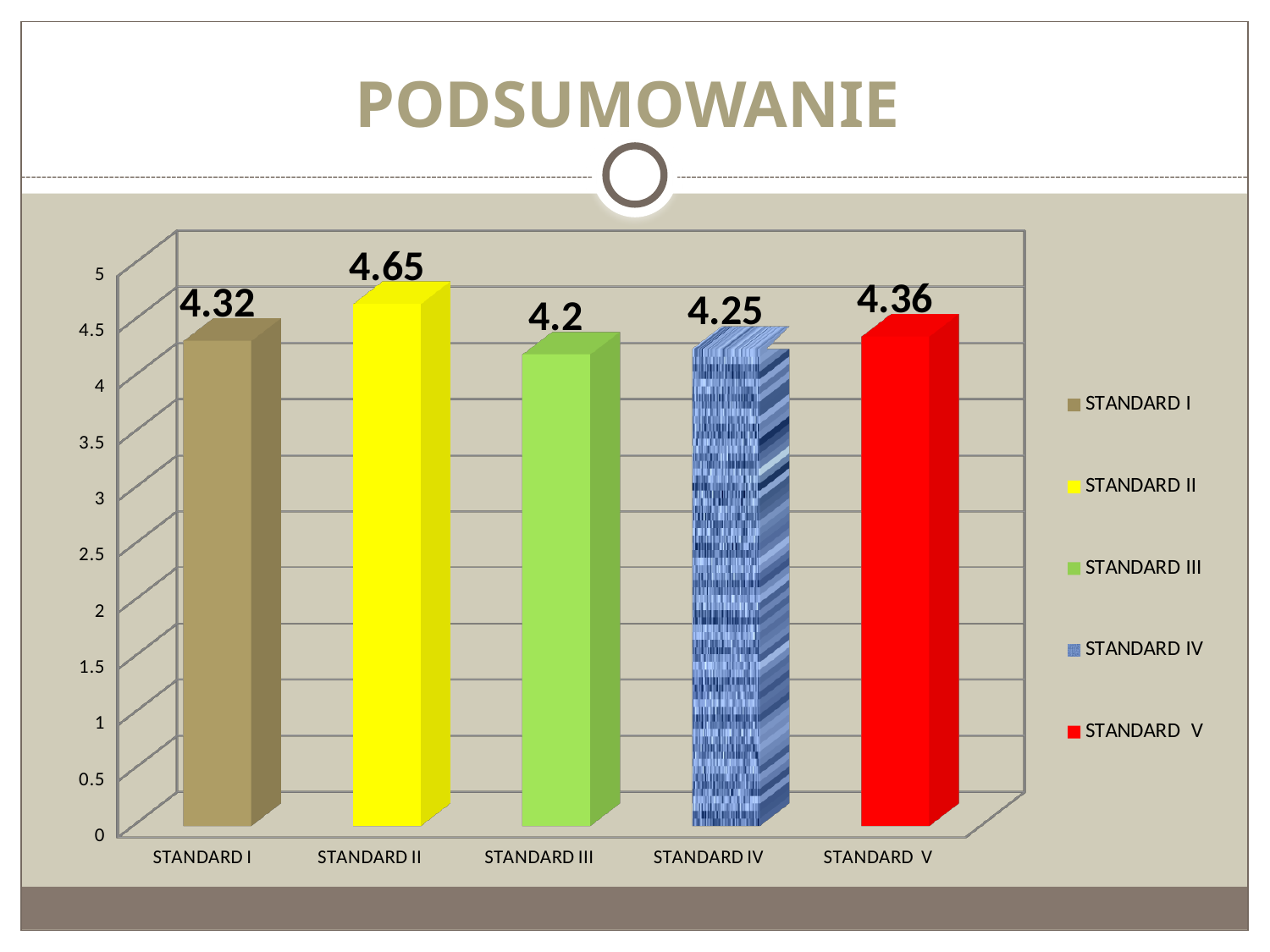
Which is larger, the value for STANDARD I or the value for STANDARD V? STANDARD V What is the value for STANDARD I? 4.32 Which category has the lowest value? STANDARD III What is the value for STANDARD II? 4.65 How many categories are shown on the x axis? 5 What is the value for STANDARD V? 4.36 What is the difference between the values for STANDARD II and STANDARD III? 0.45 What is the value for STANDARD IV? 4.25 What is the value for STANDARD III? 4.2 How many entries does the legend list? 5 What kind of chart is shown on the slide? bar chart Which category has the highest value? STANDARD II